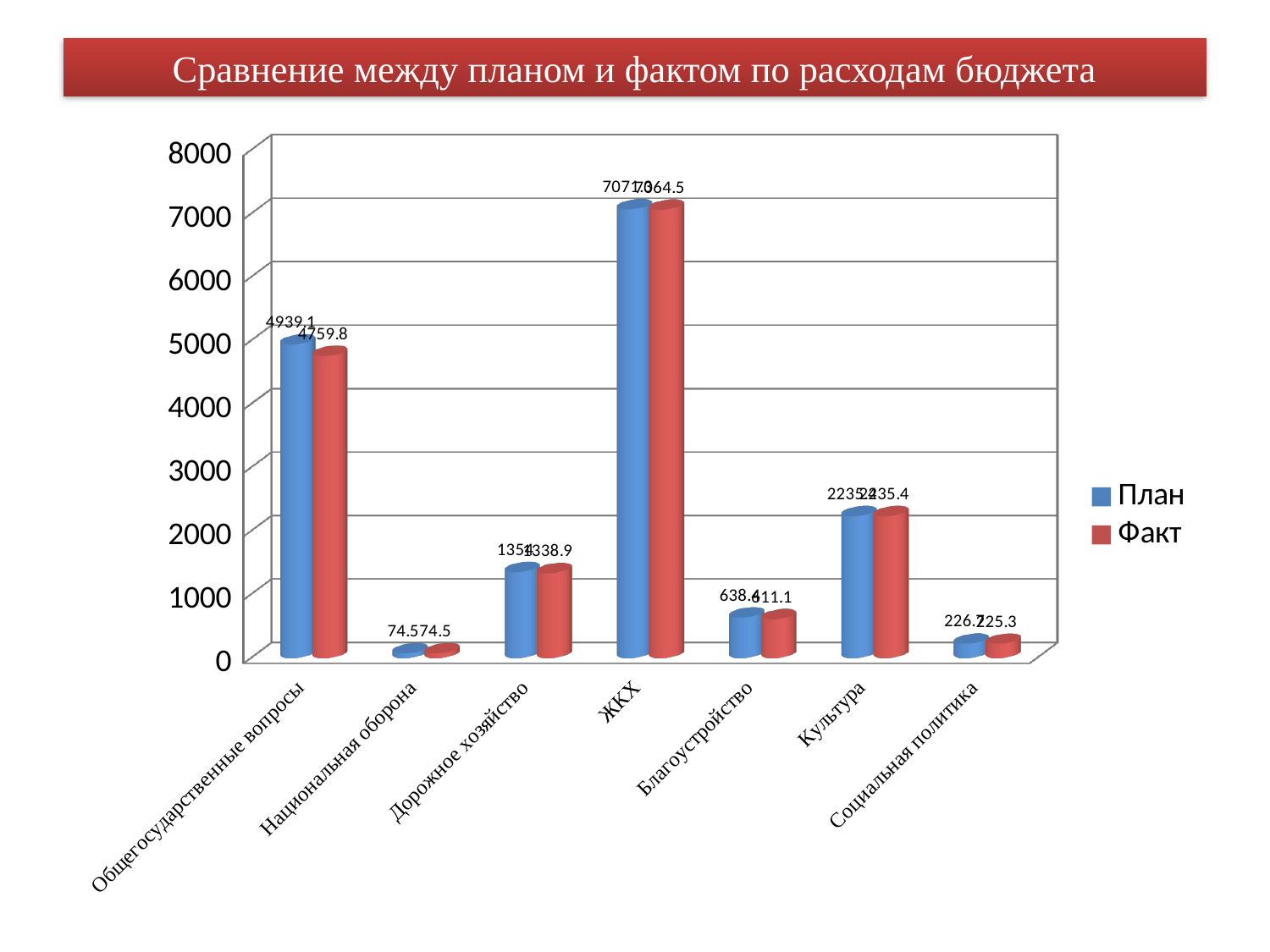
What is the Факт value for ЖКХ? 7064.5 Which category has the lowest Факт value? Национальная оборона What kind of chart is shown on the slide? bar chart What is the Факт value for Общегосударственные вопросы? 4759.8 Which category has the highest План value? ЖКХ Is the План value for Культура greater or less than 2000? greater What is the difference between the План and Факт values for Общегосударственные вопросы? 179.3 What is the План value for Общегосударственные вопросы? 4939.1 How many categories are shown on the x axis? 7 Which has the larger Факт value, Дорожное хозяйство or Благоустройство? Дорожное хозяйство What is the title of the chart? Сравнение между планом и фактом по расходам бюджета How many series does the legend list? 2